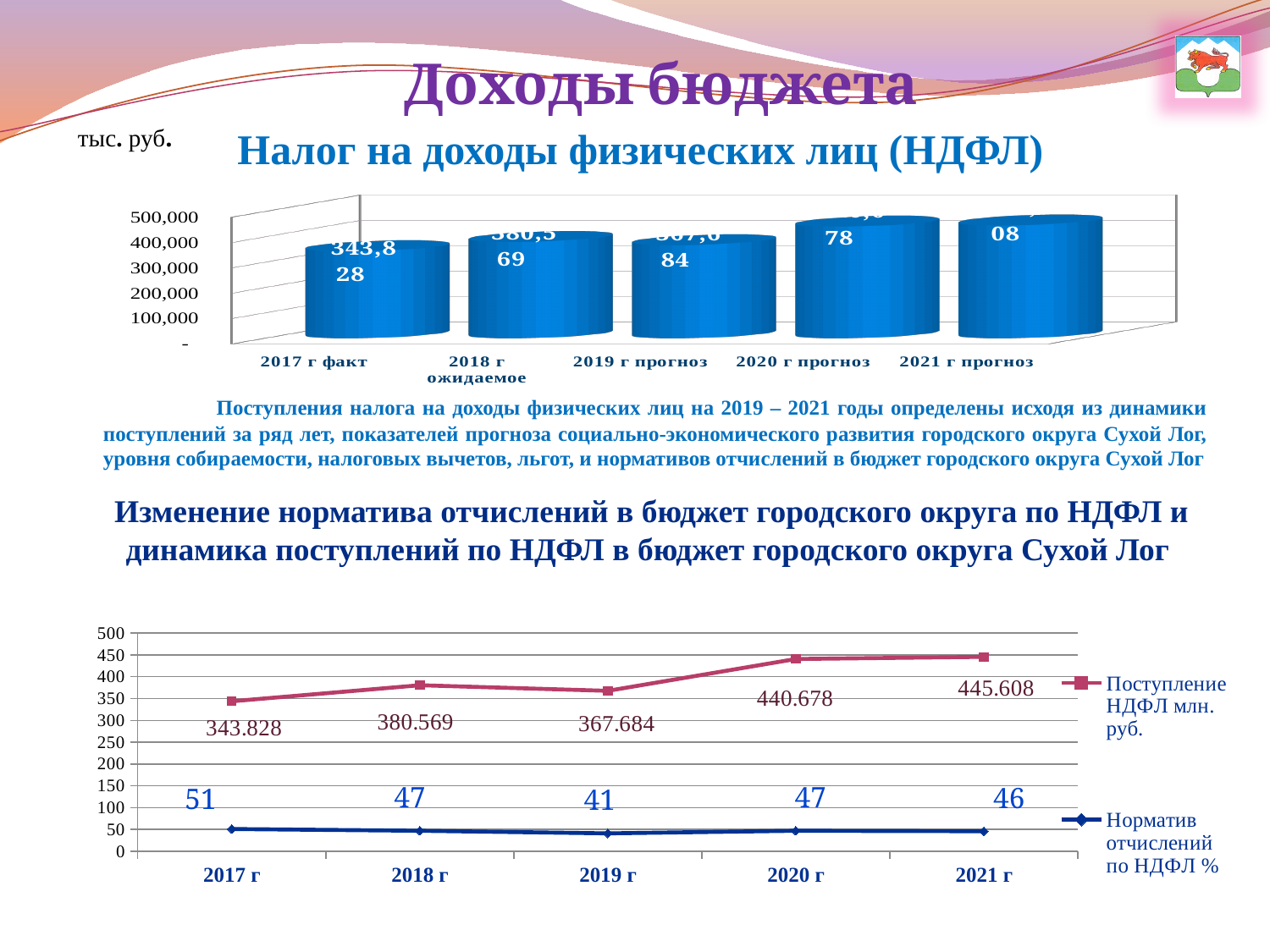
How many categories are shown on the x axis of the top chart? 5 In the bottom chart, what is the difference between Норматив отчислений по НДФЛ % in 2017 г and 2019 г? 10 In the top chart, is the value for 2020 г прогноз greater or less than 400,000? greater In the bottom chart, what is the value of Поступление НДФЛ млн. руб. for 2021 г? 445.608 In the bottom chart, which year has the highest Поступление НДФЛ млн. руб.? 2021 г In the bottom chart, which is larger: Поступление НДФЛ млн. руб. in 2018 г or in 2019 г? 2018 г What kind of chart is the top chart titled Налог на доходы физических лиц (НДФЛ)? bar chart In the bottom chart, what is the value of Поступление НДФЛ млн. руб. for 2019 г? 367.684 How many series does the legend of the bottom chart list? 2 In the bottom chart, which year has the lowest Норматив отчислений по НДФЛ %? 2019 г In the top chart, which category has the lowest value? 2017 г факт In the bottom chart, what is the value of Норматив отчислений по НДФЛ % for 2017 г? 51